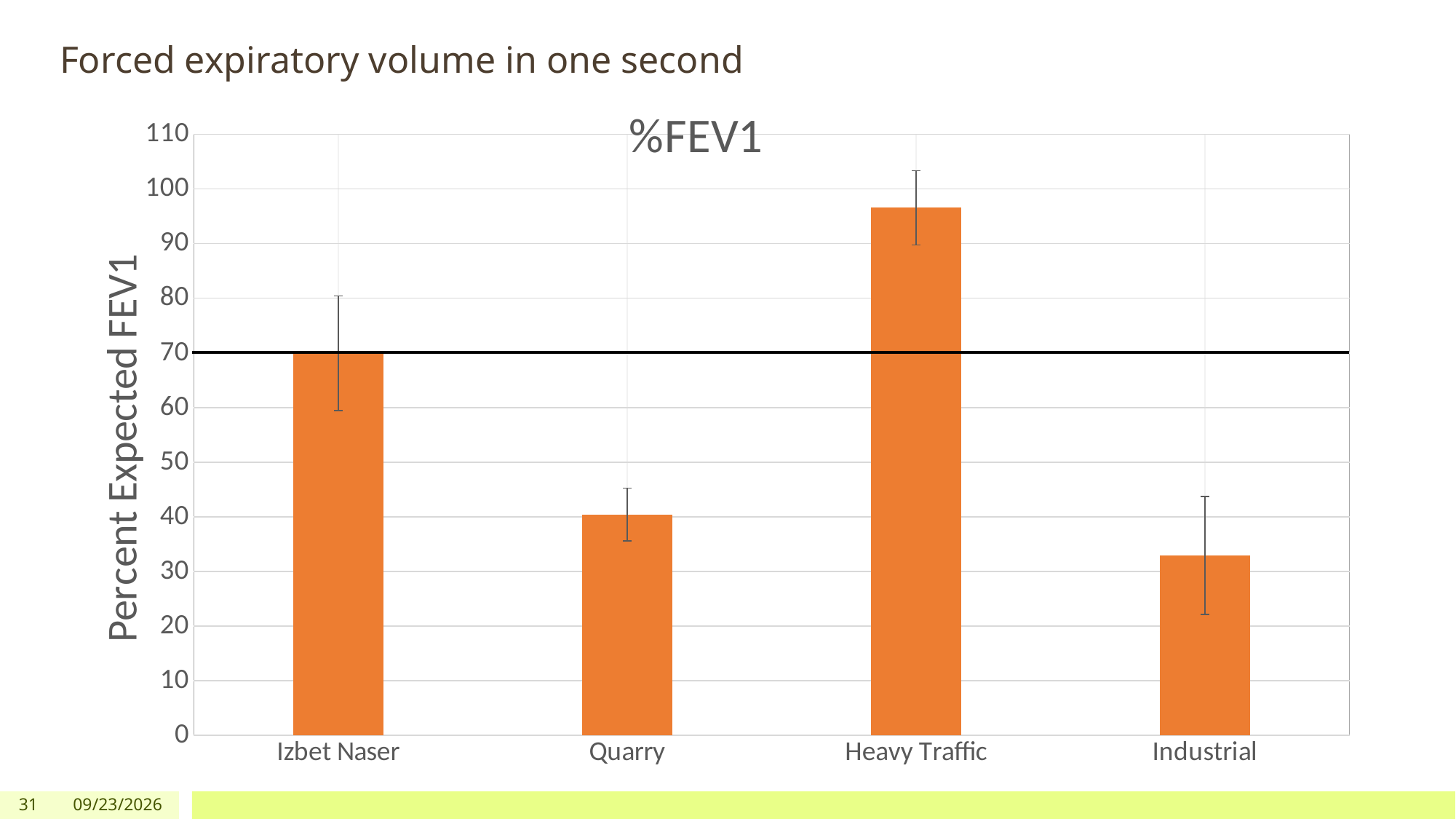
Which has the larger %FEV1 value, Quarry or Industrial? Quarry Is the value for Industrial greater or less than 40? less What kind of chart is shown on the slide? bar chart How many categories are plotted on the x axis of the %FEV1 chart? 4 Which category has the highest %FEV1 value? Heavy Traffic Is the value for Izbet Naser greater or less than 60? greater What is the label on the vertical axis of the chart? Percent Expected FEV1 Is the value for Quarry greater or less than 50? less What is the title of the chart? %FEV1 Which has the larger %FEV1 value, Izbet Naser or Heavy Traffic? Heavy Traffic Which category has the lowest %FEV1 value? Industrial